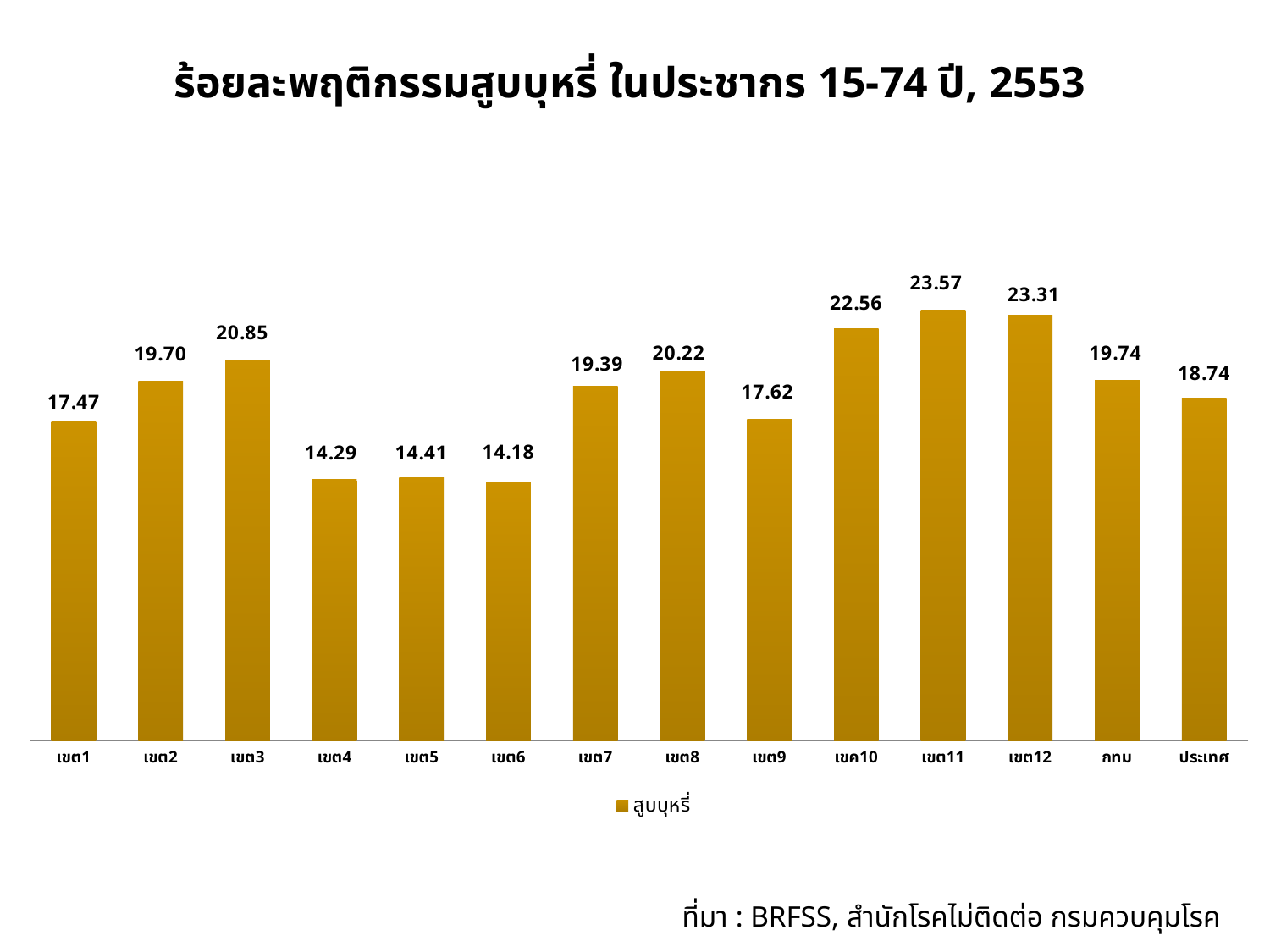
Which category has the lowest value? เขต6 What is the value for เขต1? 17.47 What is the difference between the values for เขต10 and เขต1? 5.09 Which category has the highest value? เขต11 What is the value for เขต11? 23.57 What is the value for กทม? 19.74 What is the single legend entry for the chart? สูบบุหรี่ What is the difference between the values for เขต11 and เขต6? 9.39 Which is larger, the value for เขต3 or the value for เขต8? เขต3 How many categories are shown on the x axis? 14 What kind of chart is shown on the slide? bar chart What is the value for ประเทศ? 18.74